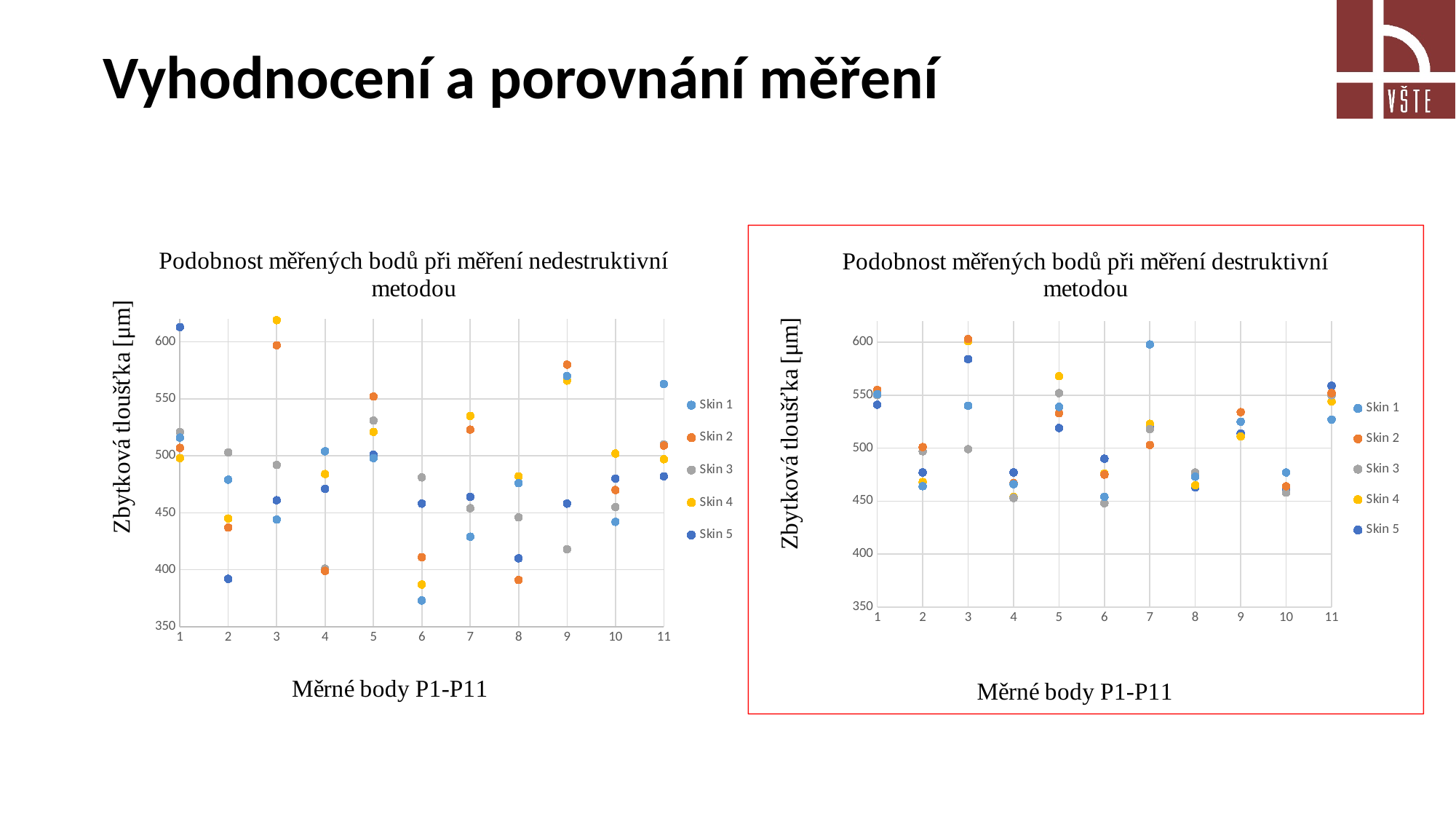
In the left chart (nedestruktivní metodou), is the value for Skin 1 at point 6 greater or less than 400? less In the left chart (nedestruktivní metodou), is the value for Skin 4 at point 3 greater or less than 600? greater In the right chart (destruktivní metodou), is the value for Skin 5 at point 3 greater or less than 550? greater In the left chart (nedestruktivní metodou), at point 3, which is larger: Skin 4 or Skin 1? Skin 4 What kind of chart is the left chart titled 'Podobnost měřených bodů při měření nedestruktivní metodou'? Scatter chart In the right chart (destruktivní metodou), at point 7, which is larger: Skin 1 or Skin 2? Skin 1 In the left chart (nedestruktivní metodou), which series has the highest value at point 3? Skin 4 What is the x-axis title of the left chart (nedestruktivní metodou)? Měrné body P1-P11 How many measurement points are shown along the x axis of the left chart (nedestruktivní metodou)? 11 How many series does the legend of the right chart (destruktivní metodou) list? 5 What is the y-axis title of the right chart (destruktivní metodou)? Zbytková tloušťka [µm]